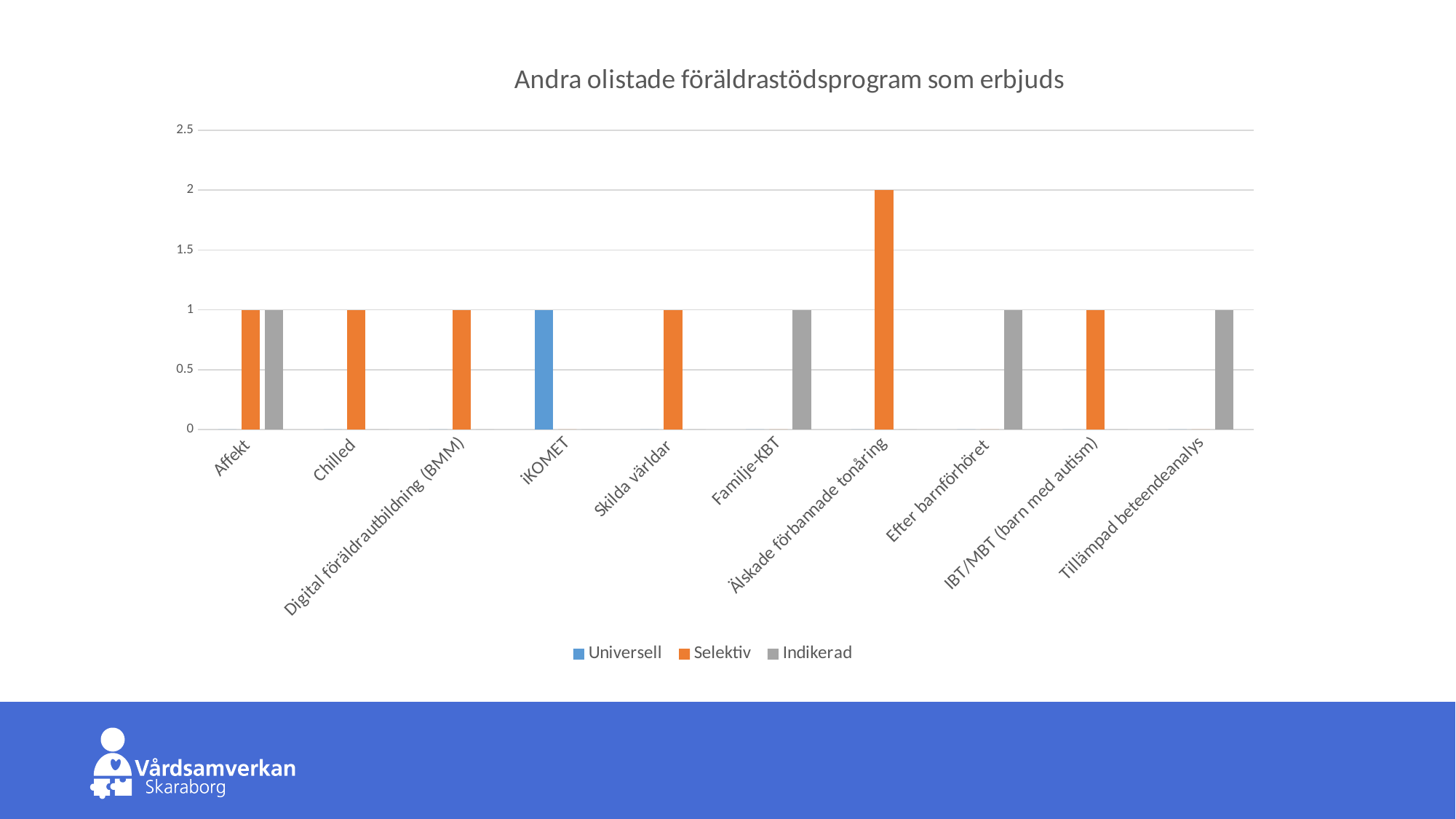
What is the Universell value for iKOMET? 1 What is the total of the Selektiv and Indikerad values for Affekt? 2 What is the Selektiv value for Älskade förbannade tonåring? 2 How many categories are shown on the x axis? 10 Which category has the highest bar in the chart? Älskade förbannade tonåring How many series does the legend list? 3 What is the title of the chart? Andra olistade föräldrastödsprogram som erbjuds Which is larger: the Selektiv value for Älskade förbannade tonåring or the Selektiv value for Skilda världar? Älskade förbannade tonåring Which category is the only one with a Universell bar? iKOMET What kind of chart is shown on the slide? Bar chart What is the Indikerad value for Familje-KBT? 1 What is the difference between the Selektiv value for Älskade förbannade tonåring and the Selektiv value for Chilled? 1